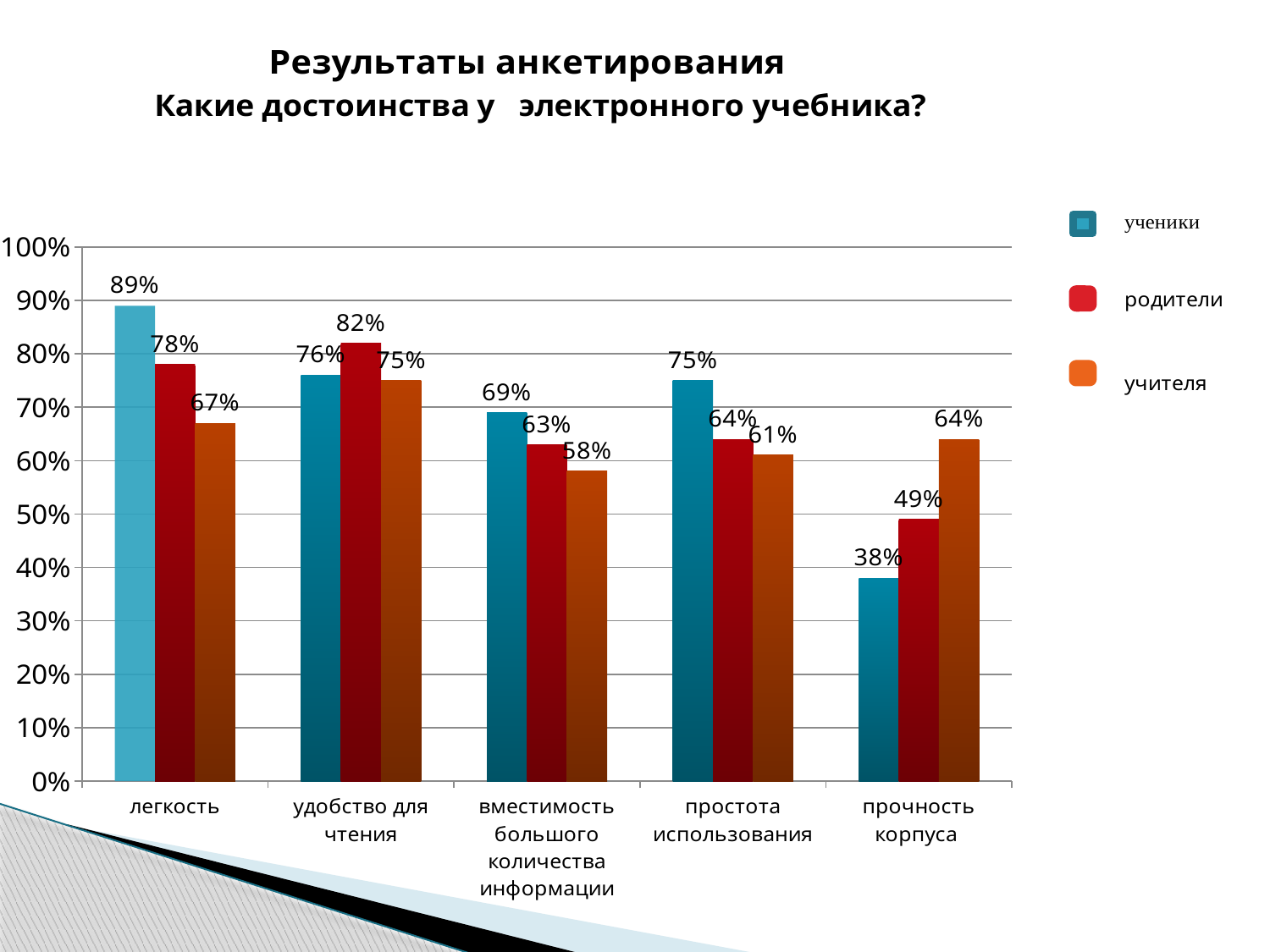
In the category прочность корпуса, which is larger: the value for ученики or the value for родители? родители Which legend entry is shown in orange? учителя Is the value for родители in the category вместимость большого количества информации greater or less than 70%? less What is the value for родители in the category удобство для чтения? 82% What is the difference between the ученики and учителя values in the category легкость? 22% What is the value for ученики in the category легкость? 89% How many series does the legend list? 3 What type of chart is shown on the slide? bar chart Which category has the highest value for учителя? удобство для чтения What is the value for учителя in the category прочность корпуса? 64% How many categories are shown on the x axis? 5 Which category has the lowest value for ученики? прочность корпуса